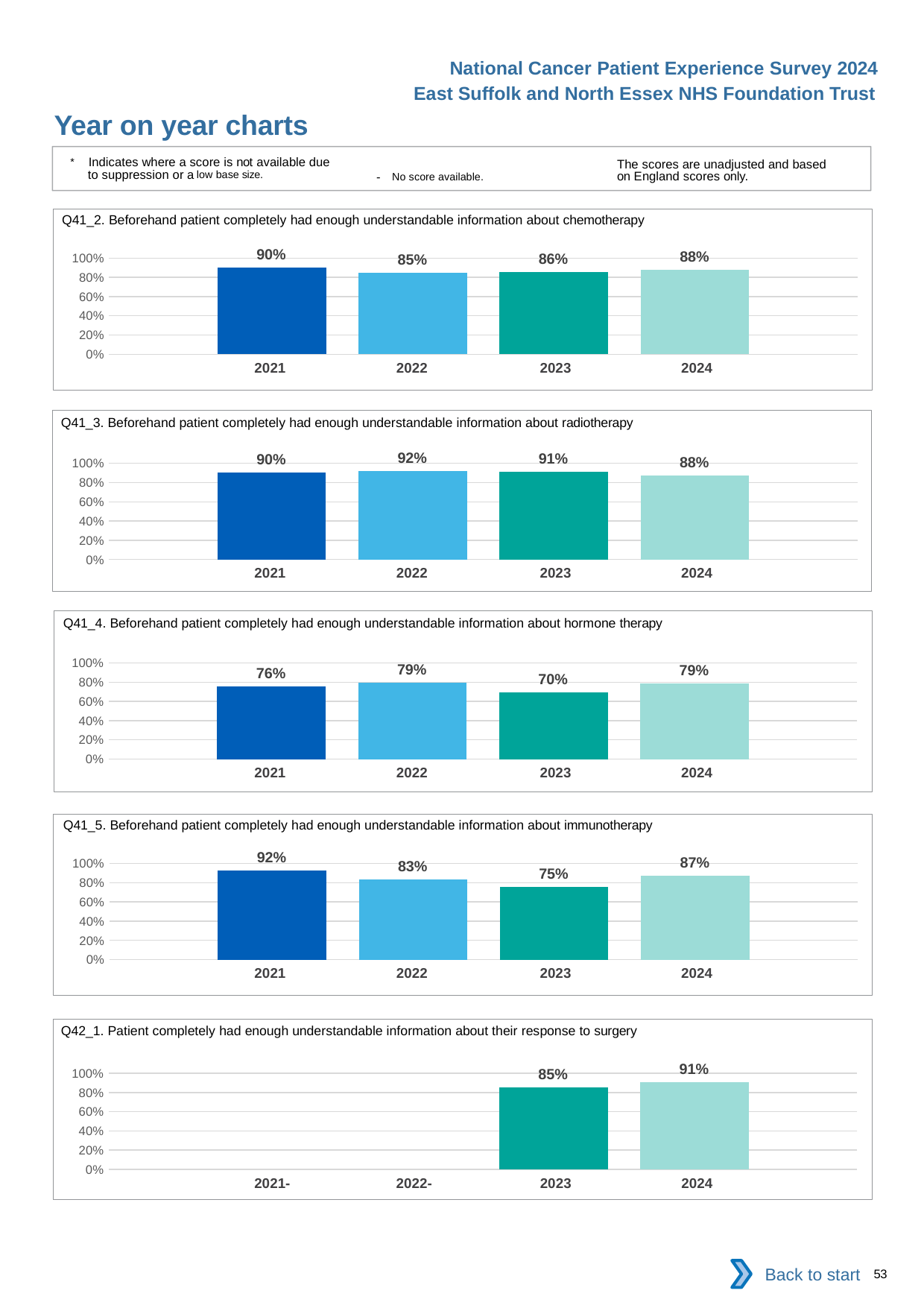
How many charts are shown on the slide? 5 In the Q42_1 chart about response to surgery, how many years have a bar plotted? 2 In the Q41_3 chart about radiotherapy, what is the value for 2024? 88% In the Q41_5 chart about immunotherapy, what is the difference between the 2021 and 2023 values? 17% In the Q41_2 chart about chemotherapy, what is the difference between the 2021 and 2022 values? 5% In the Q41_4 chart about hormone therapy, is the value for 2023 greater or less than 80%? less In the Q41_5 chart about immunotherapy, what is the value for 2022? 83% In the Q42_1 chart about response to surgery, which is larger, the value for 2023 or 2024? 2024 In the Q41_3 chart about radiotherapy, which year has the highest value? 2022 In the Q41_4 chart about hormone therapy, which year has the lowest value? 2023 What kind of chart is the Q41_2 chart about chemotherapy? bar chart In the Q41_2 chart about chemotherapy, what is the value for 2021? 90%